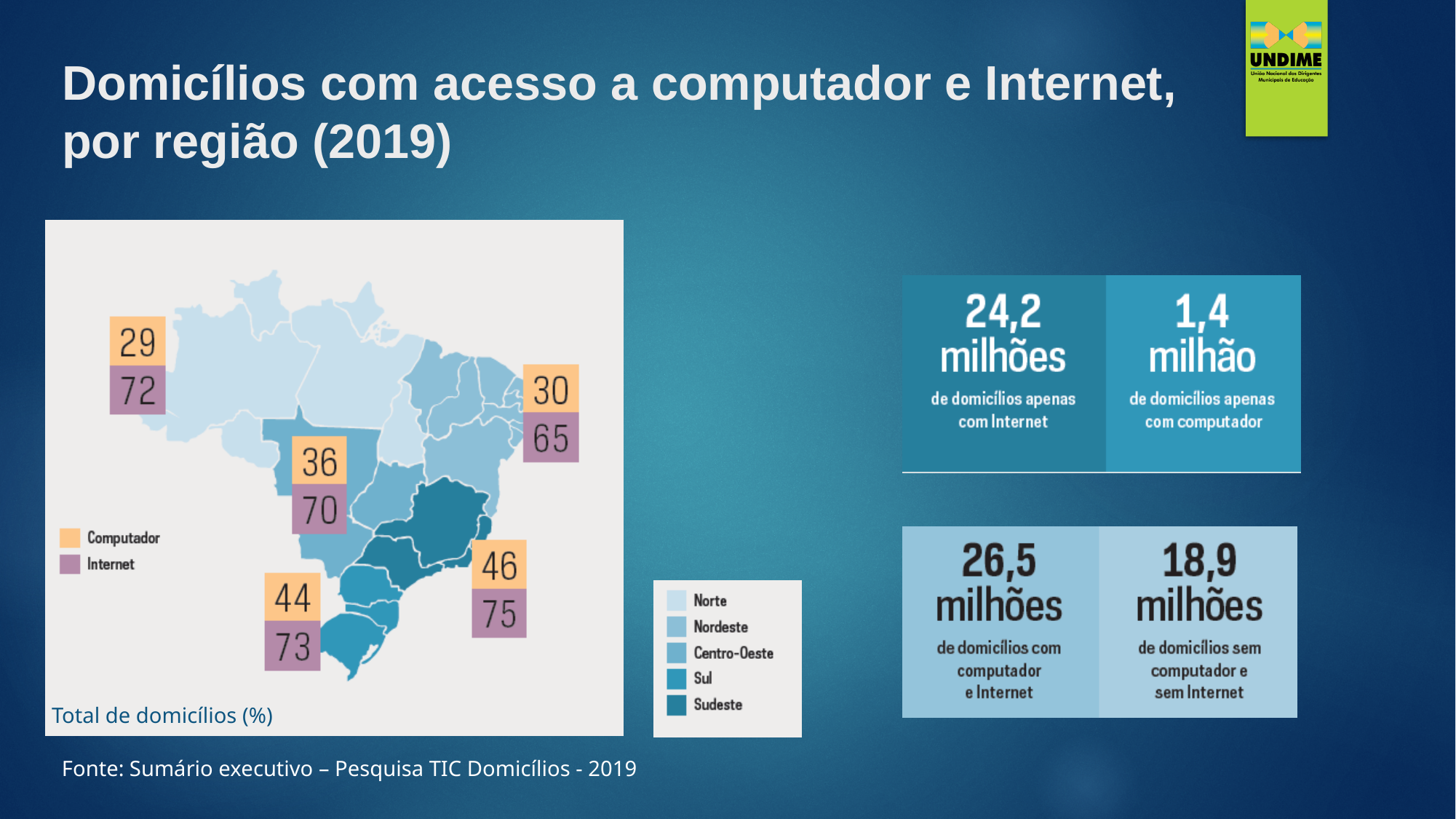
In the infographic on the right, how many households have neither computer nor Internet? 18,9 milhões In the infographic on the right, how many households have only Internet access? 24,2 milhões On the map chart, what is the difference between the Internet and Computador values for the Centro-Oeste region? 34 On the map chart, which colour represents the Internet series? Purple On the map chart, what is the Computador value for the Norte region? 29 On the map chart, which region has the lowest Computador value? Norte On the map chart, what is the Computador value for the Sudeste region? 46 On the map chart, which is larger: the Computador value for Sul or for Centro-Oeste? Sul On the map chart, which region has the highest Internet value? Sudeste How many regions are shown on the map chart? 5 How many series does the Computador/Internet legend on the map chart list? 2 On the map chart, what is the Internet value for the Nordeste region? 65